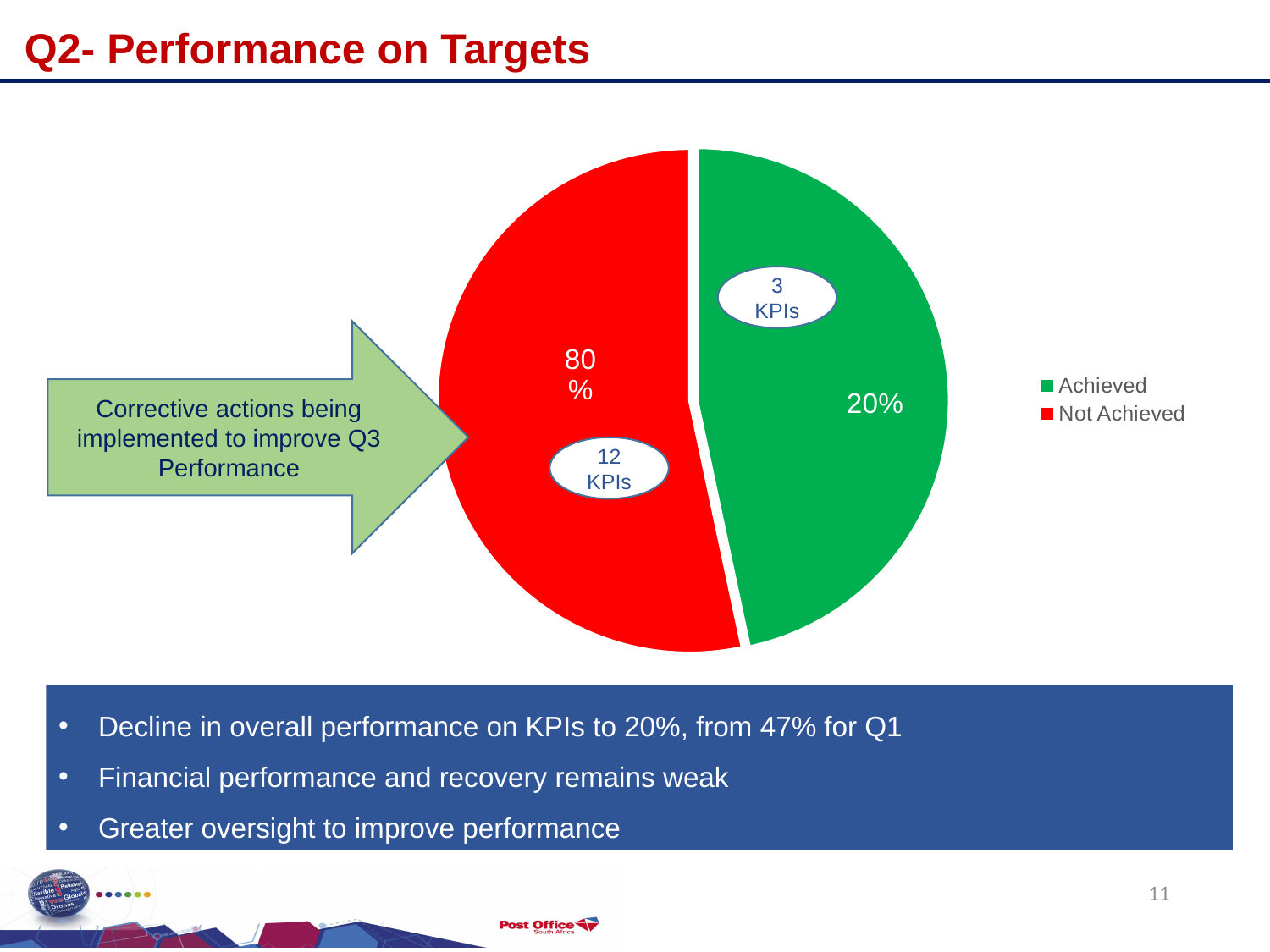
How many KPIs are shown in the callout on the Achieved slice? 3 KPIs What kind of chart is shown on the slide? pie chart Which category has the smallest share of the pie? Achieved Which category has the largest share of the pie? Not Achieved Which slice is larger, Achieved or Not Achieved? Not Achieved How many KPIs are shown in the callout on the Not Achieved slice? 12 KPIs What percentage of the pie is labelled Not Achieved? 80% How many categories does the legend list? 2 What is the difference in percentage points between the Not Achieved and Achieved slices? 60 What colour is the Achieved slice? green What percentage of the pie is labelled Achieved? 20% What colour is the Not Achieved slice? red